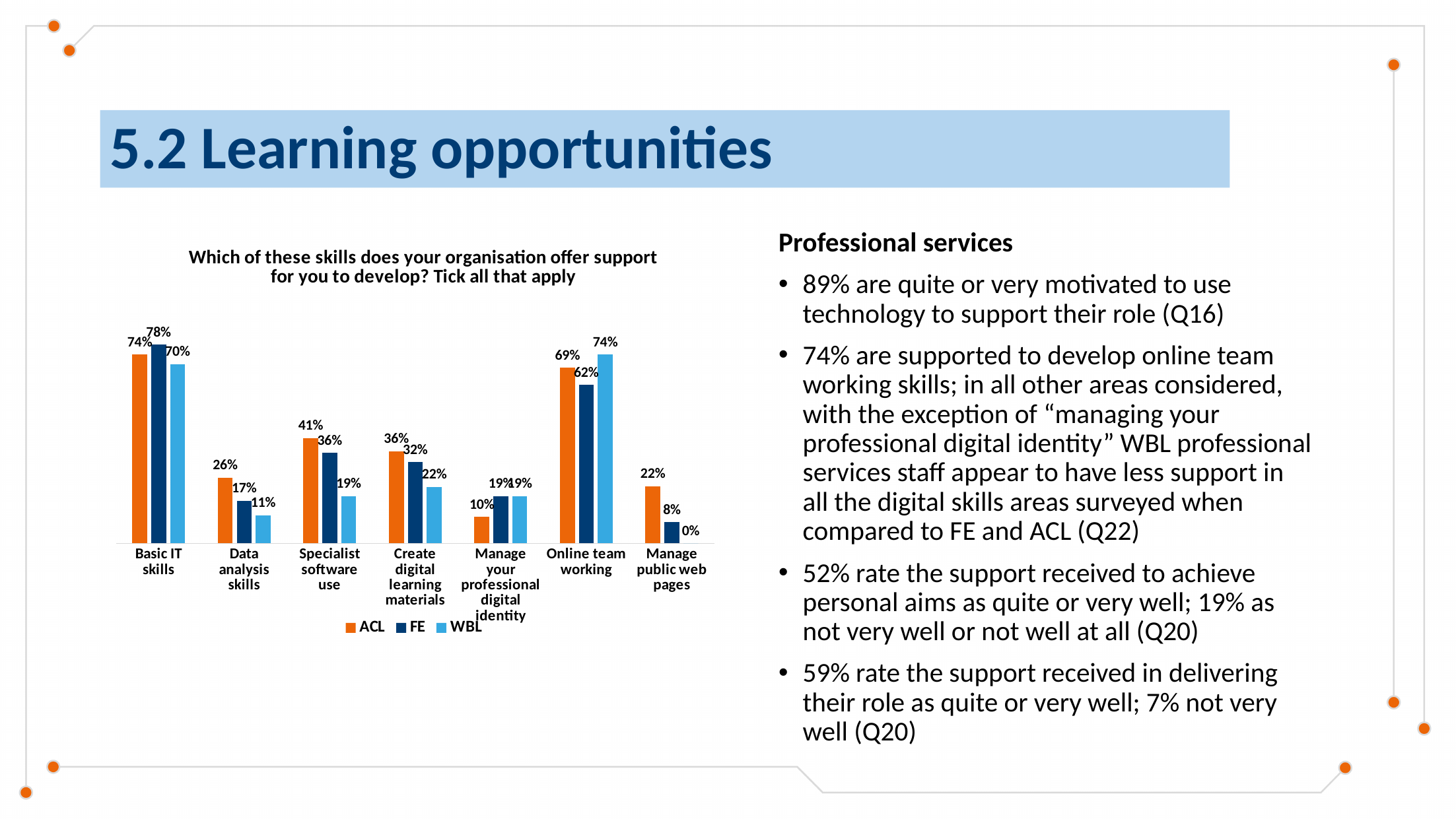
What is the WBL value for Manage public web pages? 0% What is the difference between the ACL and WBL values for Data analysis skills? 15% What is the FE value for Basic IT skills? 78% How many skill categories are shown on the x axis? 7 Which category has the highest ACL value? Basic IT skills What percentage of WBL respondents are supported to develop online team working skills? 74% Which category has the lowest FE value? Manage public web pages How many series does the legend list? 3 What type of chart is shown on the slide? Bar chart For Online team working, which series has the larger value, ACL or FE? ACL Which series is shown in orange in the legend? ACL What is the ACL value for Specialist software use? 41%